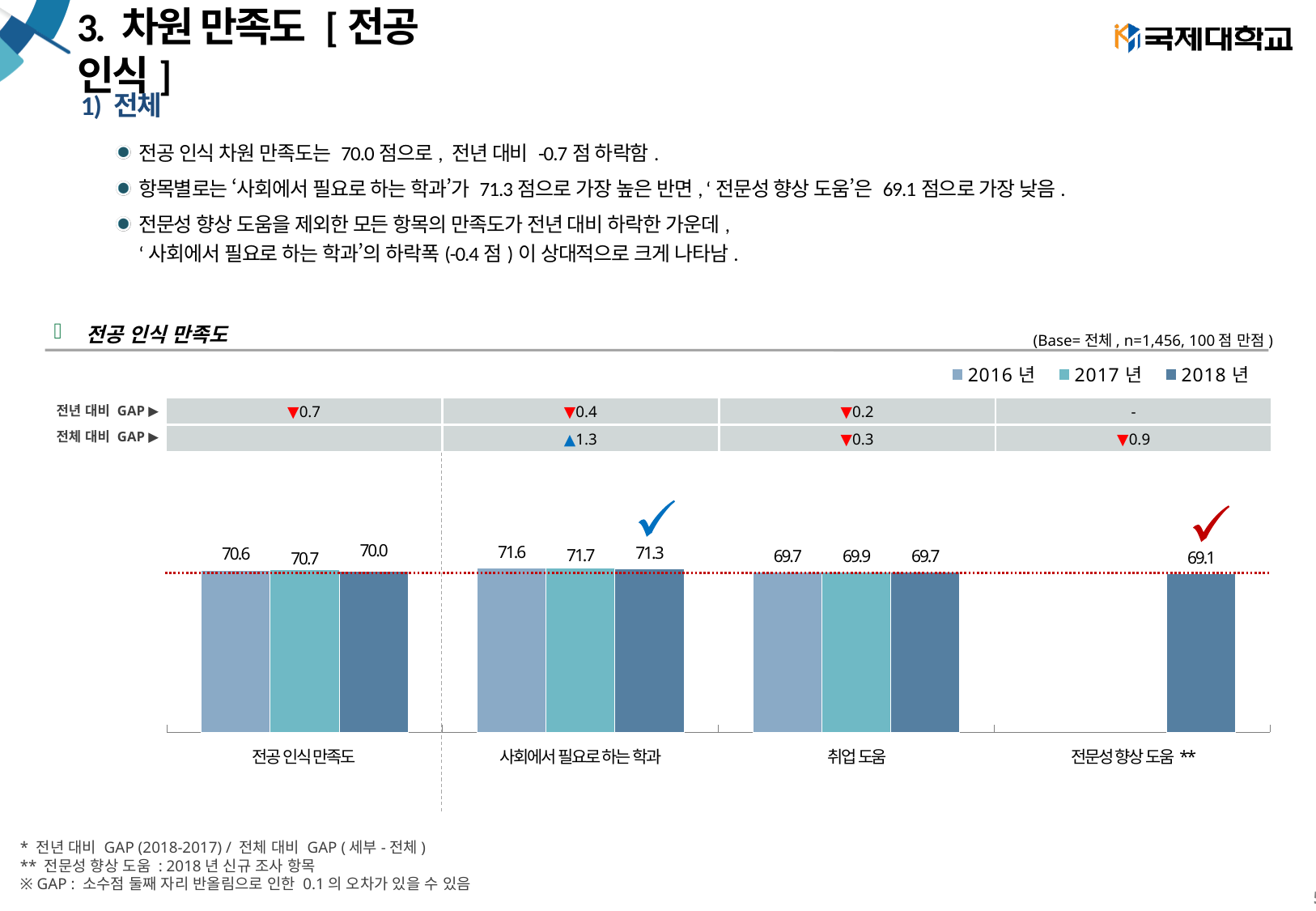
What kind of chart is shown on the slide? bar chart What is the 2018년 value for 사회에서 필요로 하는 학과? 71.3 How many categories are shown on the x axis of the chart? 4 What is the title of the chart? 전공 인식 만족도 Which category has the lowest 2018년 value? 전문성 향상 도움 How many series does the legend list? 3 Which is larger, the 2017년 value for 취업 도움 or the 2017년 value for 사회에서 필요로 하는 학과? 사회에서 필요로 하는 학과 What is the 2018년 value for 전문성 향상 도움? 69.1 Which category has the highest 2018년 value? 사회에서 필요로 하는 학과 What is the difference between the 2017년 and 2018년 values for 전공 인식 만족도? 0.7 What is the 2016년 value for 취업 도움? 69.7 What is the 2017년 value for 전공 인식 만족도? 70.7